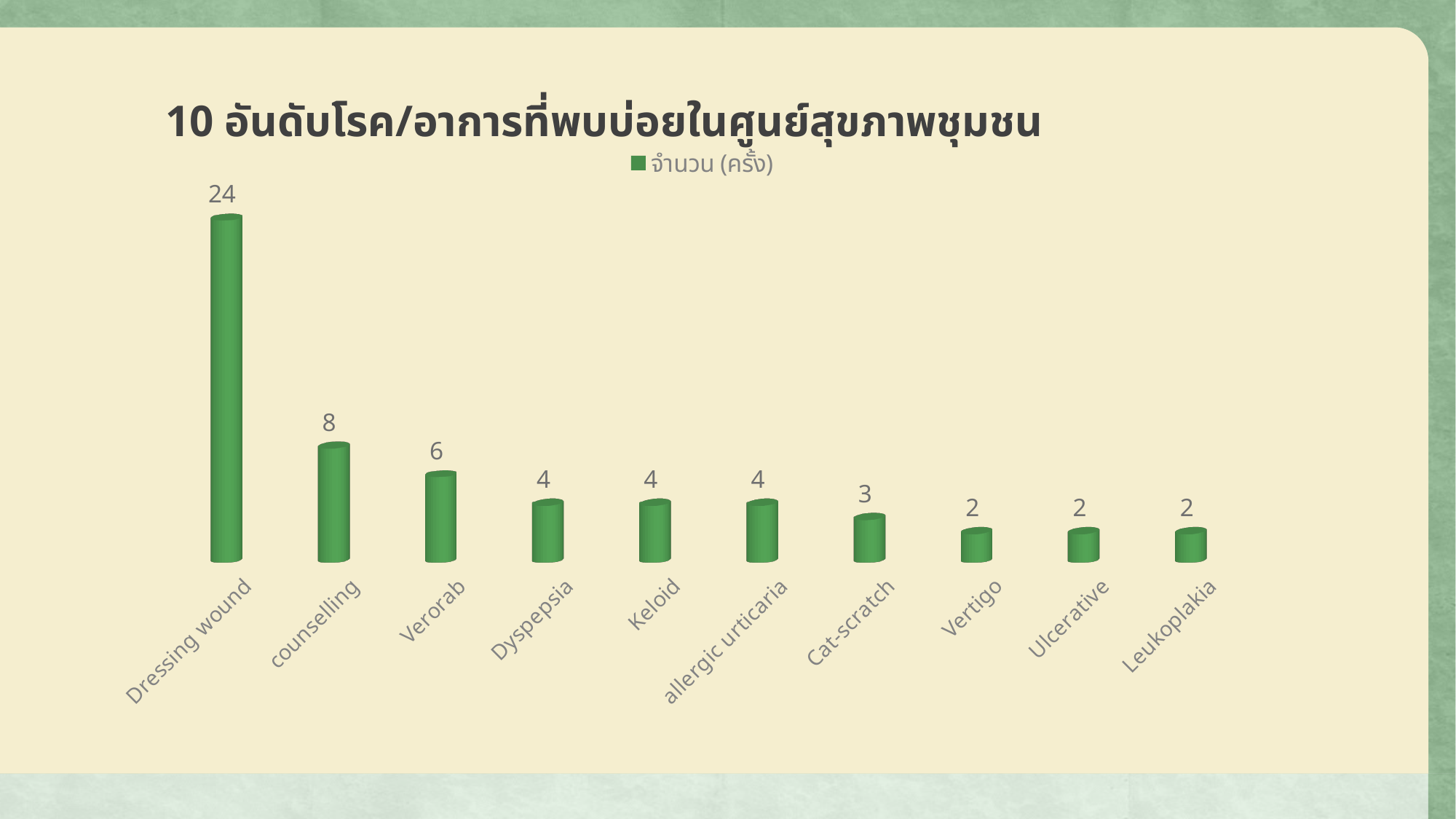
How many series does the legend list? 1 What is the value for Verorab? 6 What is the difference between the values for Verorab and Vertigo? 4 What is the value for Dressing wound? 24 What is the value for Cat-scratch? 3 Do the values rise or fall from left to right along the x axis? fall How many categories are shown on the x axis? 10 What kind of chart is shown on the slide? bar chart What is the difference between the values for Dressing wound and counselling? 16 What is the value for counselling? 8 Which category has the highest value? Dressing wound Which is larger, the value for counselling or the value for Keloid? counselling